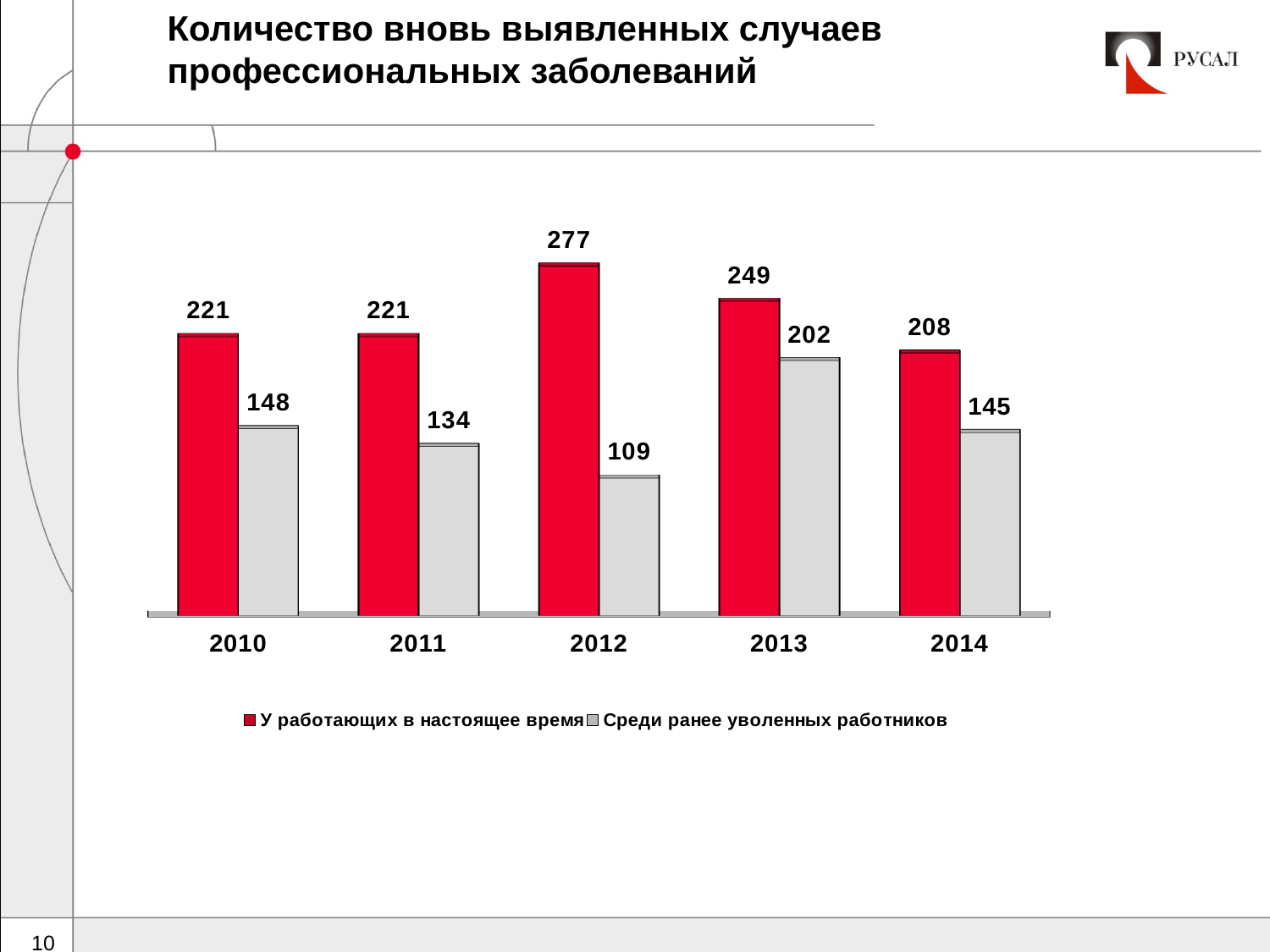
What is the difference between the 'У работающих в настоящее время' values for 2013 and 2014? 41 What is the difference between the two series in 2012? 168 What is the value for 'Среди ранее уволенных работников' in 2010? 148 Which series is shown in red? У работающих в настоящее время How many series does the legend list? 2 Which is larger: 'Среди ранее уволенных работников' in 2011 or in 2014? 2014 What kind of chart is shown on the slide? bar chart How many years are shown on the x axis? 5 What is the value for 'Среди ранее уволенных работников' in 2013? 202 In which year is the value for 'Среди ранее уволенных работников' lowest? 2012 What is the value for 'У работающих в настоящее время' in 2012? 277 In which year is the value for 'У работающих в настоящее время' highest? 2012